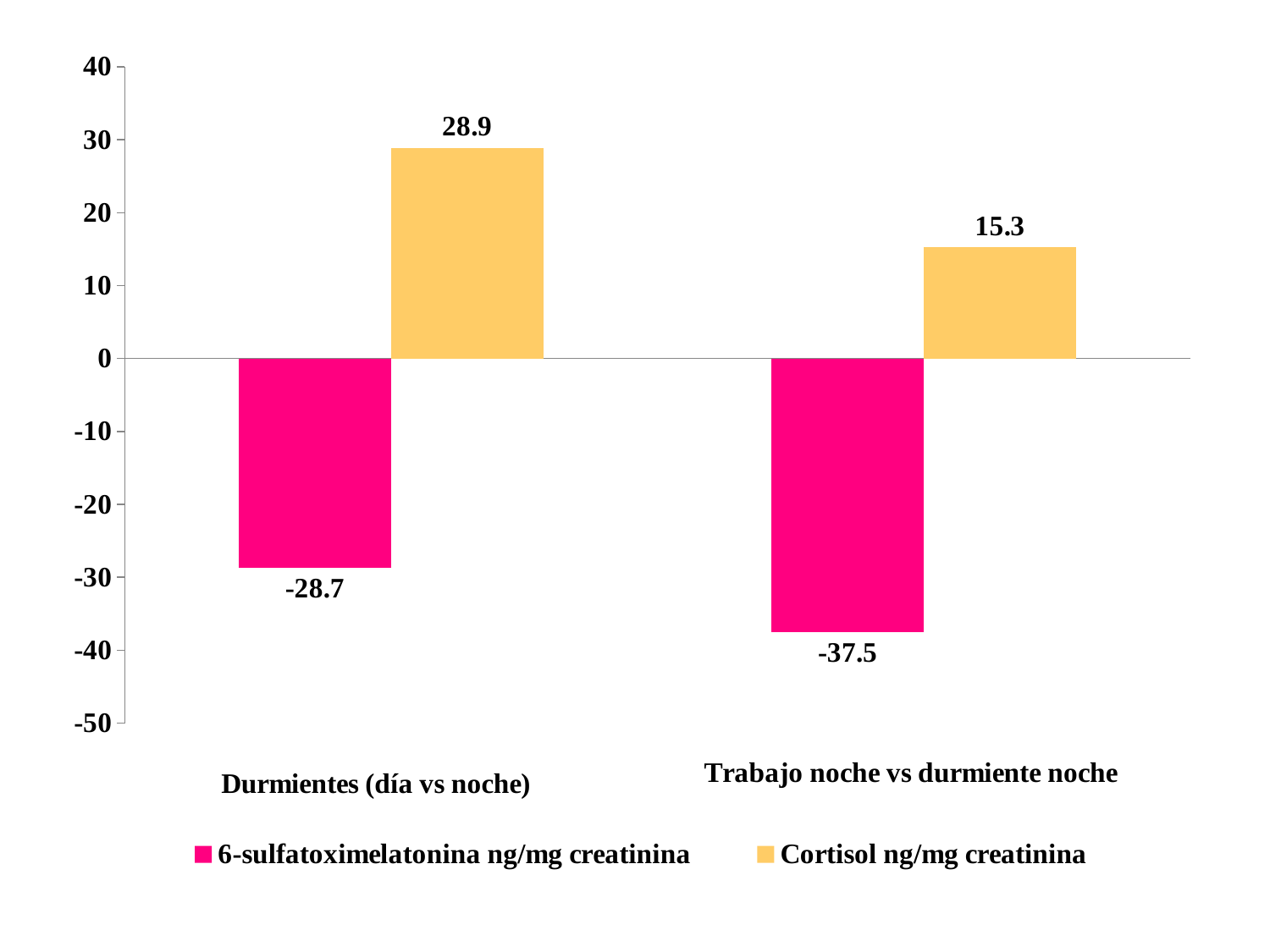
What is the value of 6-sulfatoximelatonina ng/mg creatinina for Trabajo noche vs durmiente noche? -37.5 Which category has the higher Cortisol ng/mg creatinina value? Durmientes (día vs noche) What is the value of Cortisol ng/mg creatinina for Durmientes (día vs noche)? 28.9 What is the value of 6-sulfatoximelatonina ng/mg creatinina for Durmientes (día vs noche)? -28.7 What is the value of Cortisol ng/mg creatinina for Trabajo noche vs durmiente noche? 15.3 What kind of chart is shown on the slide? Bar chart Is the 6-sulfatoximelatonina ng/mg creatinina value for Trabajo noche vs durmiente noche greater or less than -30? less Which category has the lowest 6-sulfatoximelatonina ng/mg creatinina value? Trabajo noche vs durmiente noche What is the difference between the Cortisol ng/mg creatinina values for Durmientes (día vs noche) and Trabajo noche vs durmiente noche? 13.6 Is the Cortisol ng/mg creatinina value for Durmientes (día vs noche) larger than the value for Trabajo noche vs durmiente noche? Yes How many categories are shown on the x axis? 2 How many series does the legend list? 2